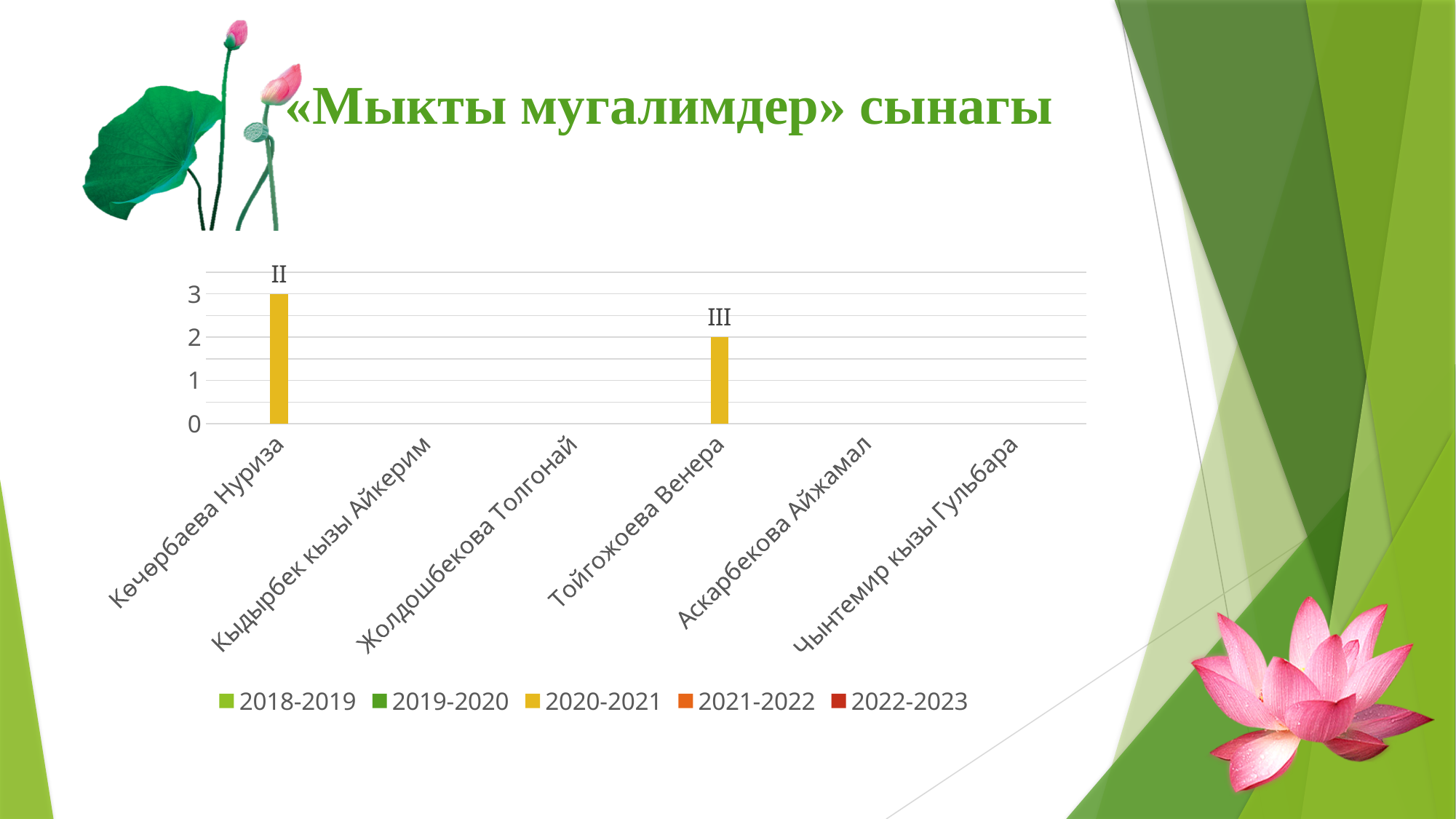
What value on the axis does the bar for Көчөрбаева Нуриза reach? 3 What data label is printed above the bar for Көчөрбаева Нуриза? II What value on the axis does the bar for Тойгожоева Венера reach? 2 What data label is printed above the bar for Тойгожоева Венера? III Which category has the highest bar? Көчөрбаева Нуриза What kind of chart is shown on the slide? bar chart What is the difference between the bar values for Көчөрбаева Нуриза and Тойгожоева Венера? 1 What is the title of the slide? «Мыкты мугалимдер» сынагы Which is larger, the bar for Көчөрбаева Нуриза or the bar for Тойгожоева Венера? Көчөрбаева Нуриза How many series does the legend list? 5 Which legend series do the two visible bars belong to? 2020-2021 How many categories are shown on the x axis? 6